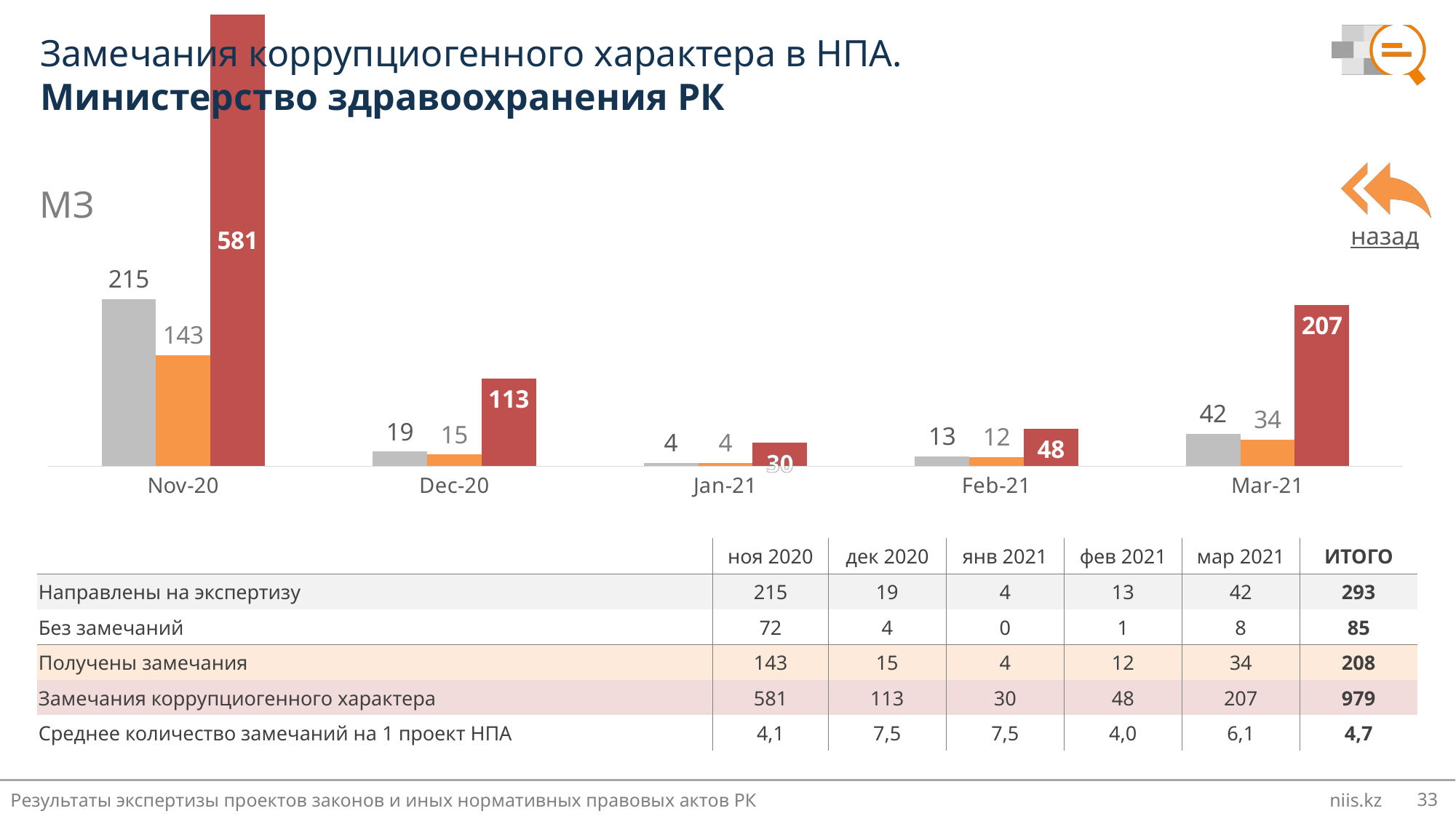
What is the x-axis label of the first group of bars in the chart? Nov-20 What is the value of the grey bar (Направлены на экспертизу) for Mar-21? 42 In which month is the grey bar (Направлены на экспертизу) the lowest? Jan-21 What is the difference between the red bar values for Nov-20 and Mar-21? 374 Do the red bar values rise or fall from Nov-20 to Jan-21? fall What type of chart is shown on the slide? bar chart Which is larger: the red bar for Dec-20 or the red bar for Feb-21? Dec-20 What is the value of the orange bar (Получены замечания) for Dec-20? 15 How many months are shown on the x axis of the chart? 5 How many data series (bar colours) are plotted for each month in the chart? 3 What is the value of the red bar (Замечания коррупциогенного характера) for Nov-20? 581 In which month is the red bar (Замечания коррупциогенного характера) the highest? Nov-20